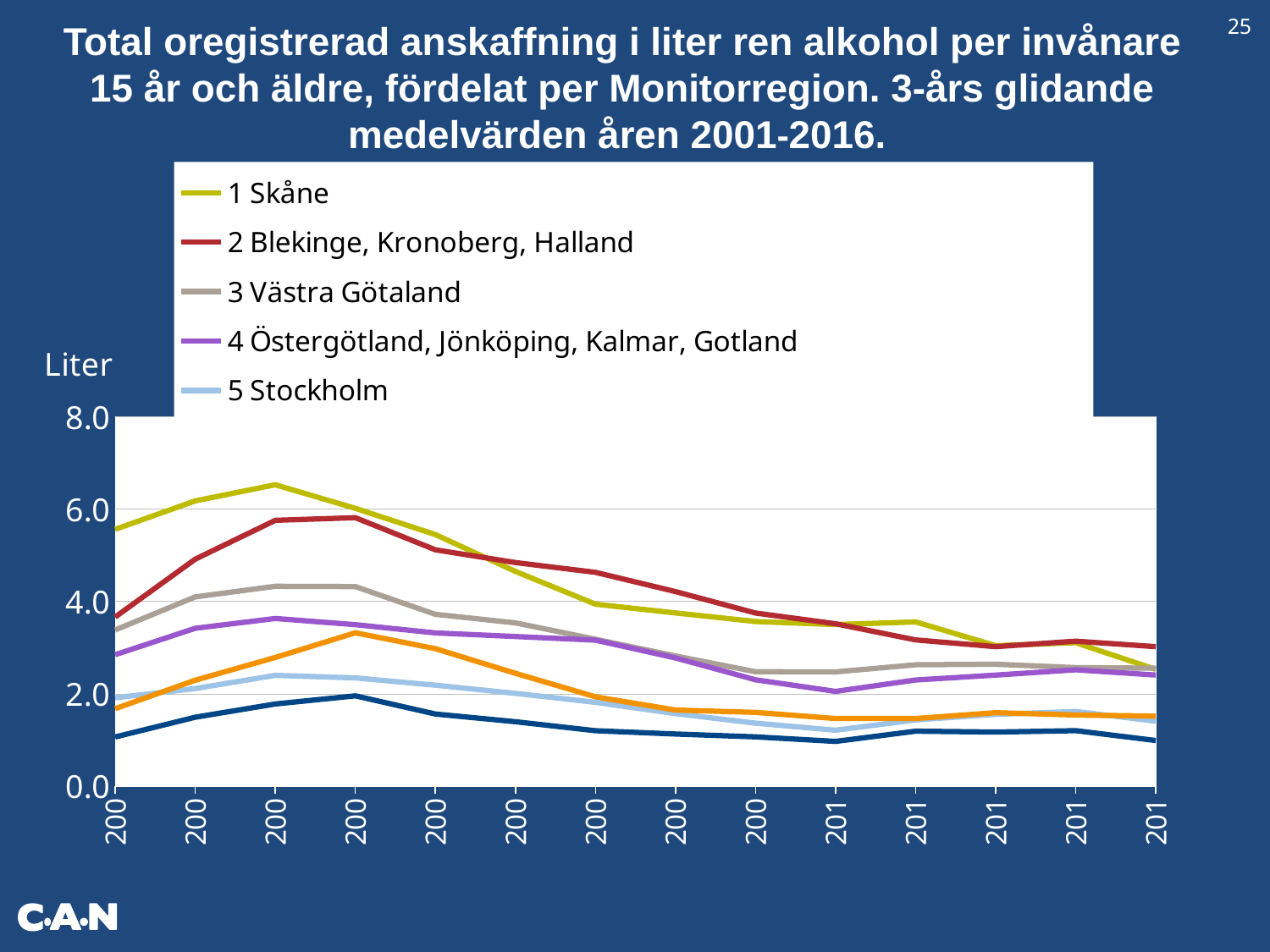
How many series does the legend list? 5 What is the label on the y axis? Liter What kind of chart is shown on the slide? line chart At the end of the period, which is larger: 2 Blekinge, Kronoberg, Halland or 3 Västra Götaland? 2 Blekinge, Kronoberg, Halland Is the value for 1 Skåne at the end of the period greater or less than 4.0? less How many points along the x axis does the chart have? 14 Is the peak value for 1 Skåne greater or less than 6.0? greater Is the value for 3 Västra Götaland at the start of the period greater or less than 4.0? less Which series has the highest value at the start of the period? 1 Skåne At the start of the period, which is larger: 1 Skåne or 5 Stockholm? 1 Skåne Overall, does the line for 1 Skåne rise or fall from the start to the end of the period? fall